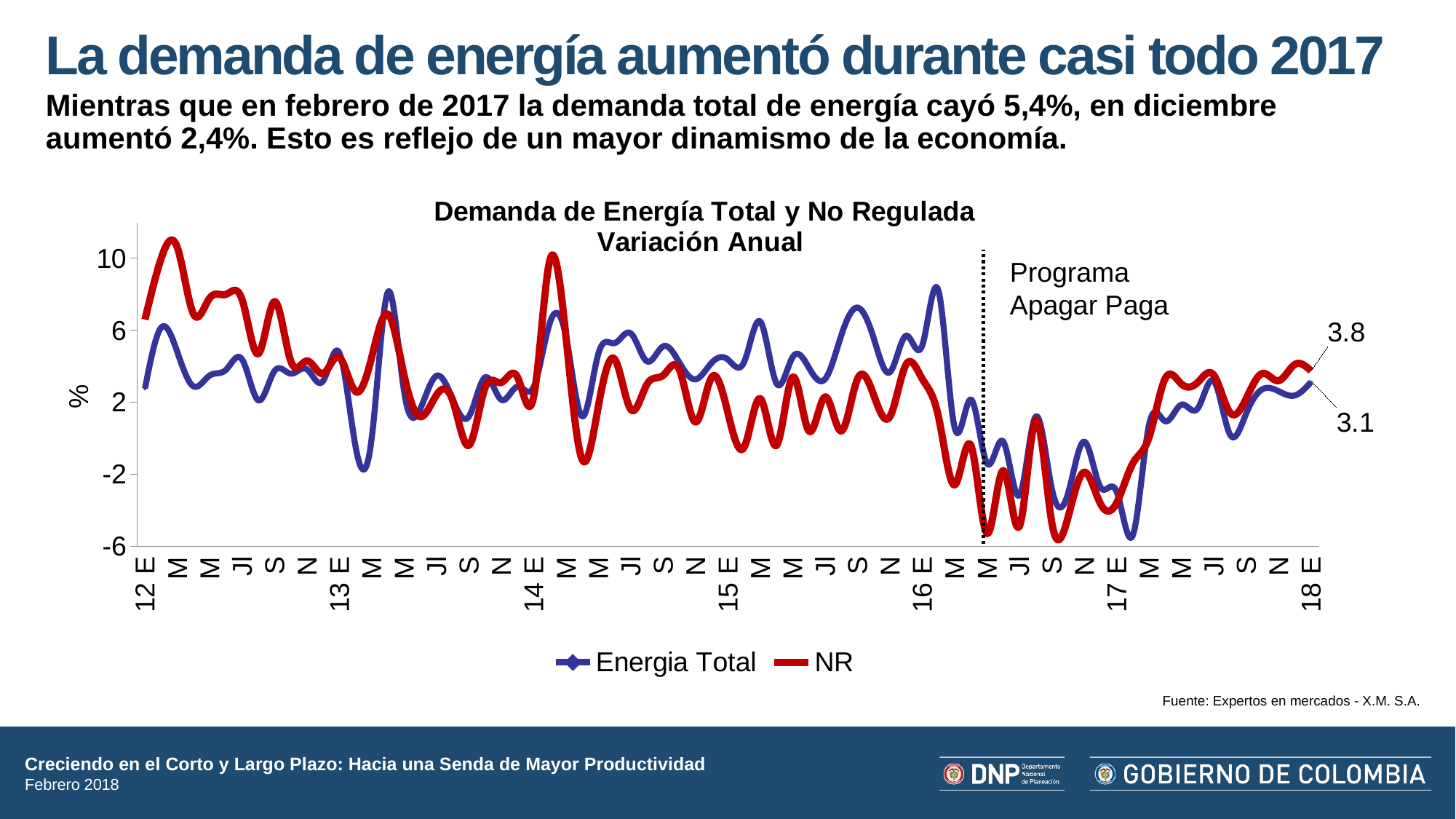
Is the value of the NR series at its peak in early 2012 (around 12 M) greater or less than 10? greater Is the value of the Energia Total series at 17 E greater or less than -2? less What is the labelled value of the Energia Total series at the last point (18 E)? 3.1 What kind of chart is shown on the slide? line chart Which series reaches the highest value anywhere on the chart, Energia Total or NR? NR How many series does the chart's legend list? 2 What is the title of the chart? Demanda de Energía Total y No Regulada Variación Anual What is the labelled value of the NR series at the last point (18 E)? 3.8 At the last point (18 E), which series has the larger value, NR or Energia Total? NR What are the two series named in the legend? Energia Total and NR What is the difference between the NR value (3.8) and the Energia Total value (3.1) at the last point (18 E)? 0.7